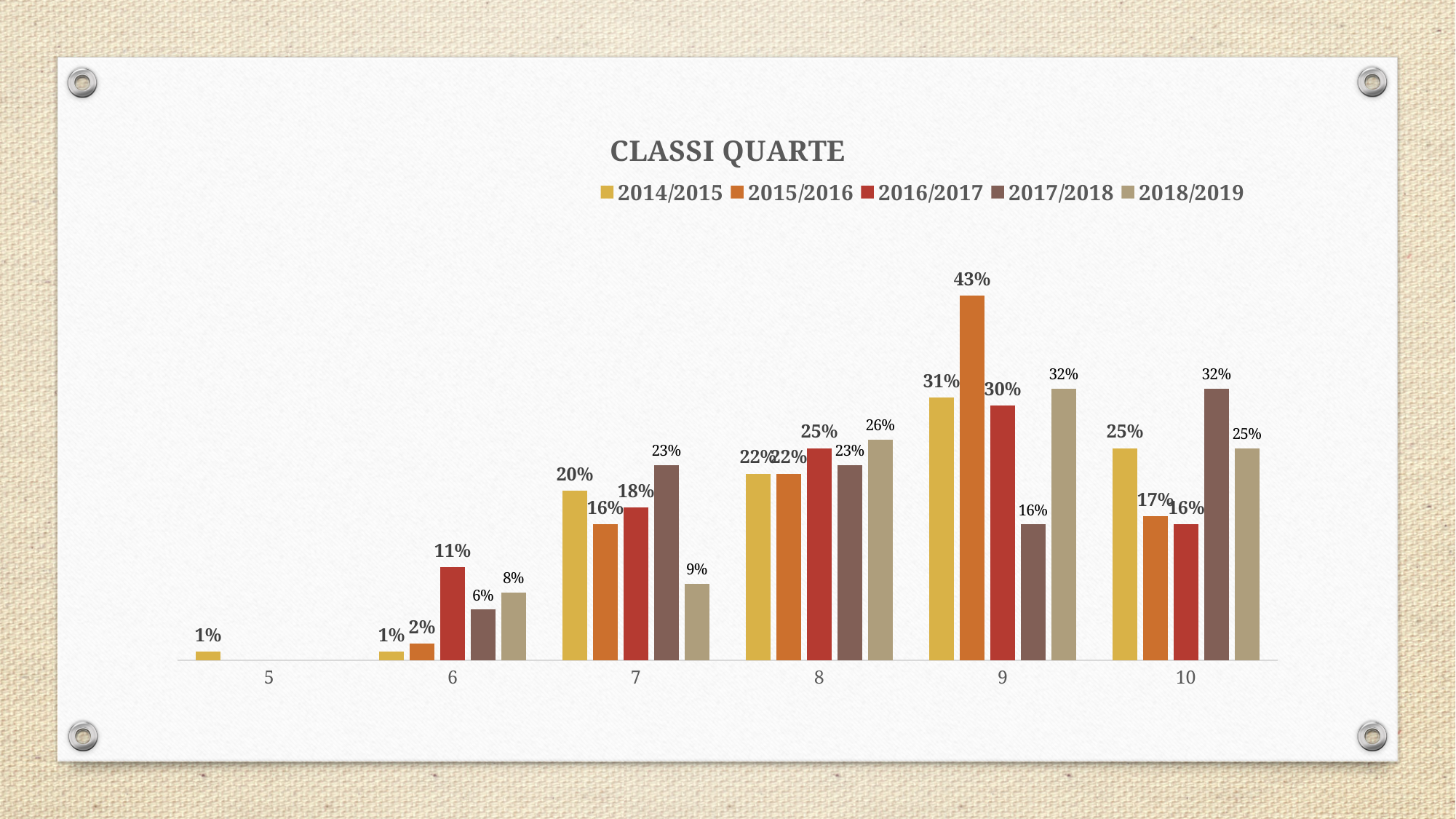
What is the value for 2018/2019 in category 7? 9% Does the 2014/2015 series rise or fall from category 5 to category 9? Rise What is the difference between the 2015/2016 value and the 2017/2018 value in category 9? 27% Which category has the highest value for the 2016/2017 series? 9 What kind of chart is shown on the slide? Bar chart How many categories are shown on the x axis? 6 What is the value for 2017/2018 in category 10? 32% In category 10, which is larger: the value for 2014/2015 or the value for 2015/2016? 2014/2015 What is the value for 2015/2016 in category 9? 43% Which series has the lowest value in category 9? 2017/2018 What is the title of the chart? CLASSI QUARTE How many series does the legend list? 5